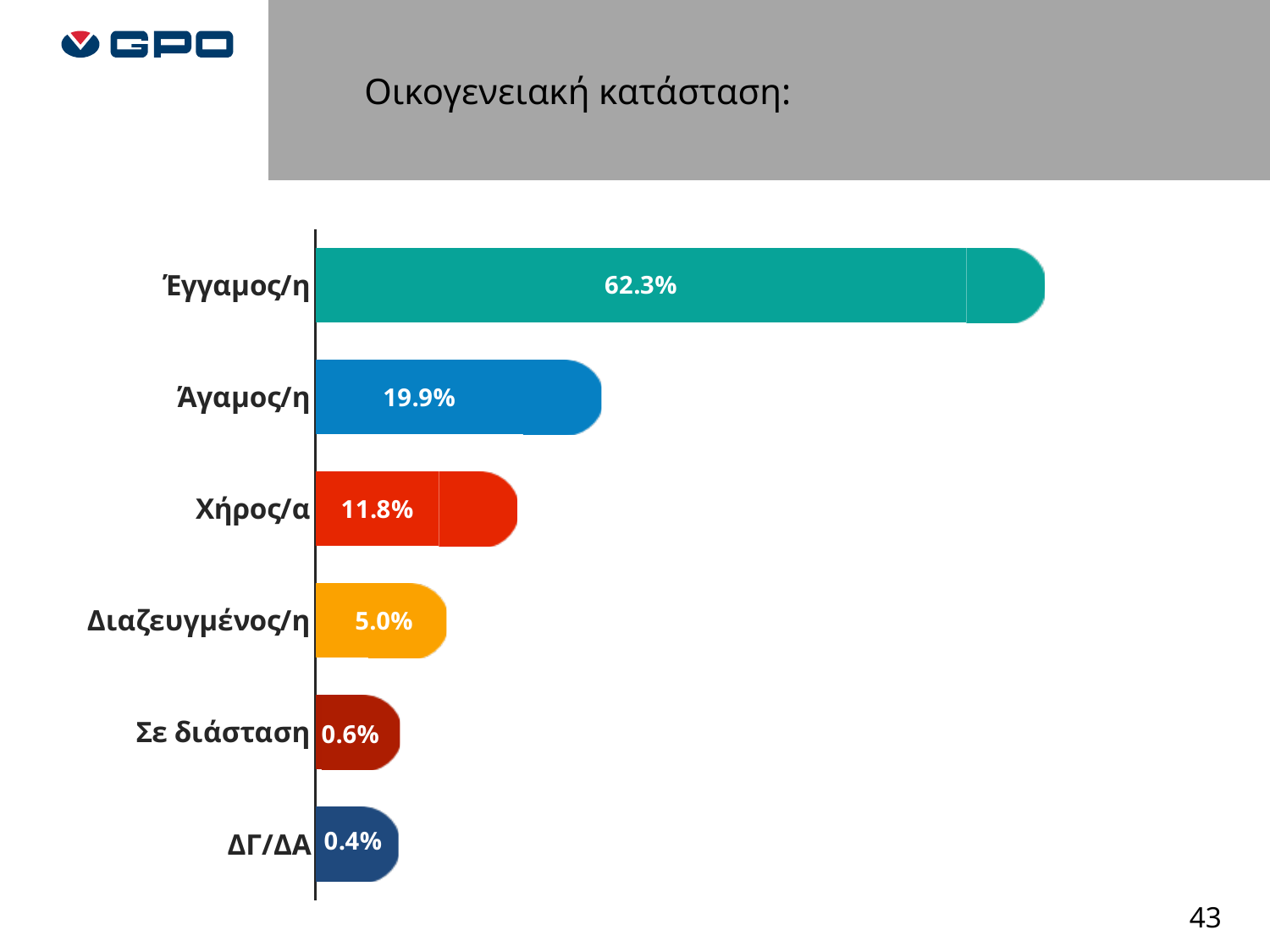
What is the value for Χήρος/α? 11.8% What kind of chart is shown on the slide? Bar chart Which category has the highest value? Έγγαμος/η What is the value for ΔΓ/ΔΑ? 0.4% What is the title of the slide? Οικογενειακή κατάσταση: Which is larger, the value for Χήρος/α or the value for Διαζευγμένος/η? Χήρος/α What is the value for Έγγαμος/η? 62.3% What is the value for Διαζευγμένος/η? 5.0% What is the difference between the values for Έγγαμος/η and Άγαμος/η? 42.4% How many categories are shown in the chart? 6 Which category has the lowest value? ΔΓ/ΔΑ What is the value for Άγαμος/η? 19.9%